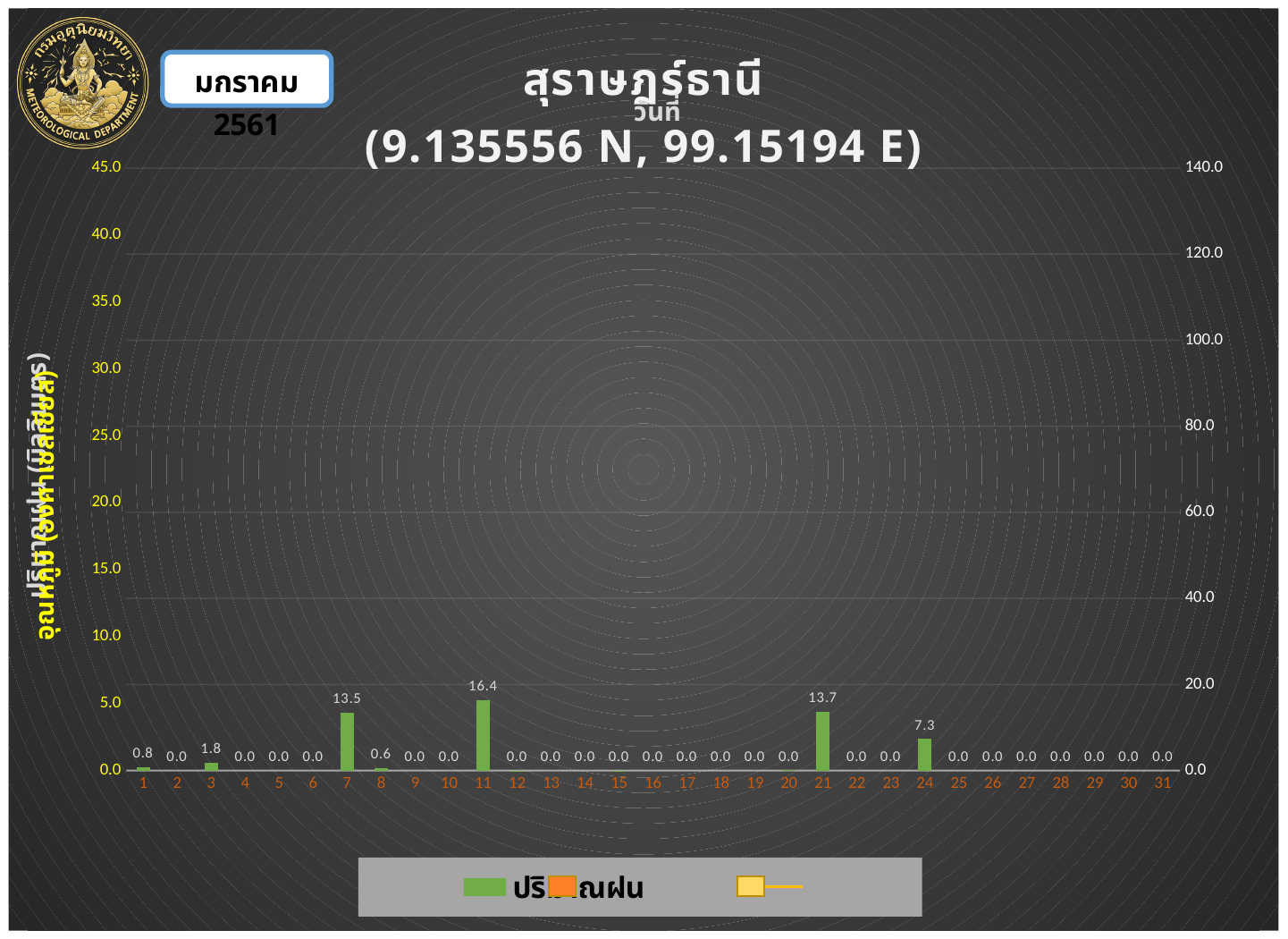
Which day has the larger rainfall value, day 7 or day 21? day 21 Which day has the highest rainfall value? 11 What is the difference between the rainfall values for day 7 and day 24? 6.2 What is the rainfall value shown for day 3? 1.8 What is the difference between the rainfall values for day 11 and day 21? 2.7 How many days are shown on the x axis? 31 What is the rainfall value shown for day 7? 13.5 What is the rainfall value shown for day 24? 7.3 Which month and year are shown in the label at the top left of the slide? มกราคม 2561 What is the rainfall value shown for day 21? 13.7 What is the rainfall value (ปริมาณฝน) shown for day 11? 16.4 What kind of chart is used to show the rainfall data? bar chart